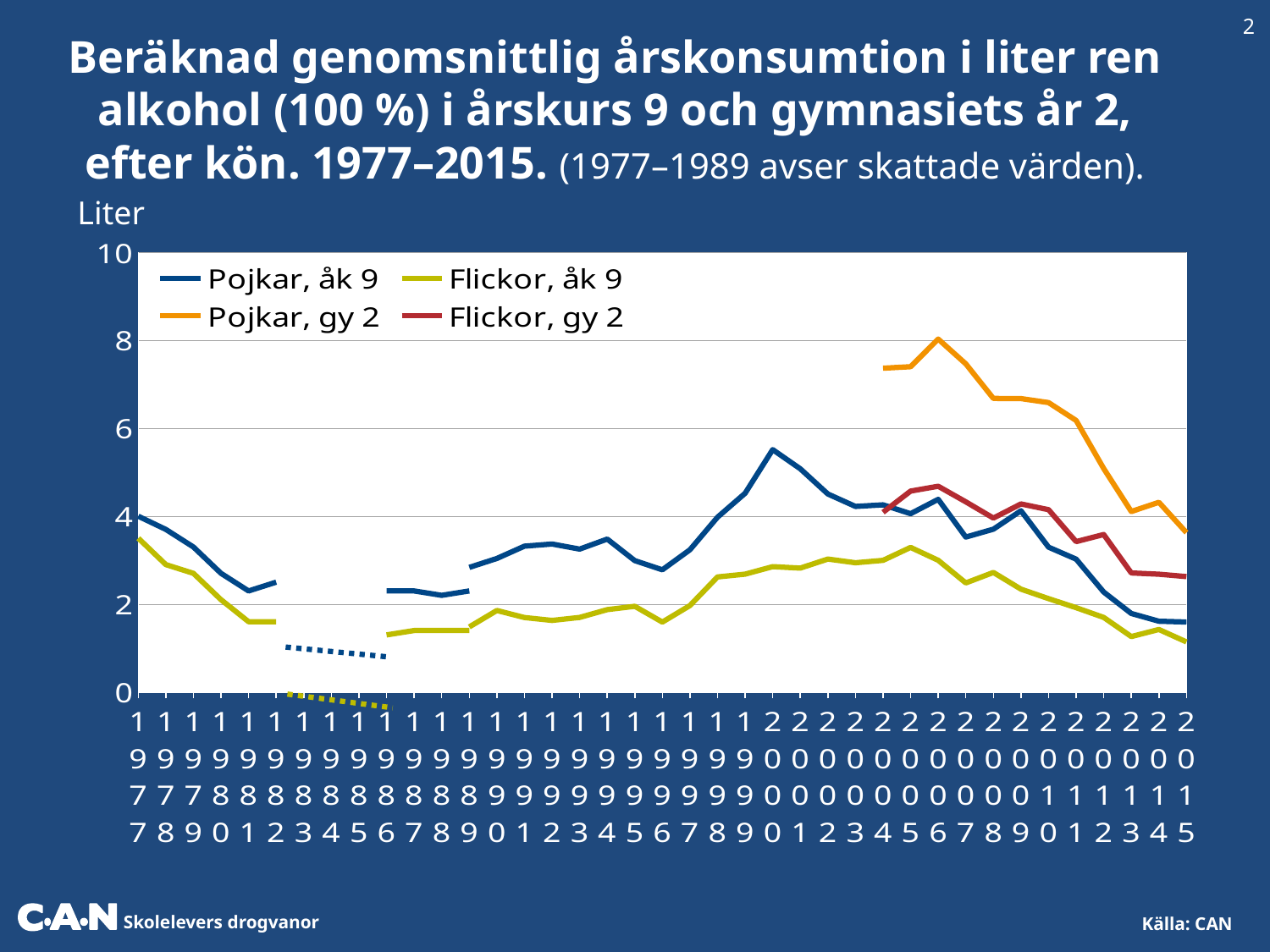
Is the value for Pojkar, åk 9 in 2000 greater or less than 4? greater Is the value for Pojkar, gy 2 in 2006 greater or less than 6? greater What is the label on the vertical axis? Liter What kind of chart is shown on the slide? line chart Is the value for Flickor, gy 2 in 2013 greater or less than 4? less In 2015, which is larger: Pojkar, gy 2 or Flickor, gy 2? Pojkar, gy 2 How many series does the legend list? 4 In 2010, which is larger: Pojkar, gy 2 or Pojkar, åk 9? Pojkar, gy 2 What are the four series listed in the legend? Pojkar, åk 9; Pojkar, gy 2; Flickor, åk 9; Flickor, gy 2 Which series has the highest value in 2006? Pojkar, gy 2 Does the Pojkar, gy 2 series rise or fall from 2006 to 2015? fall